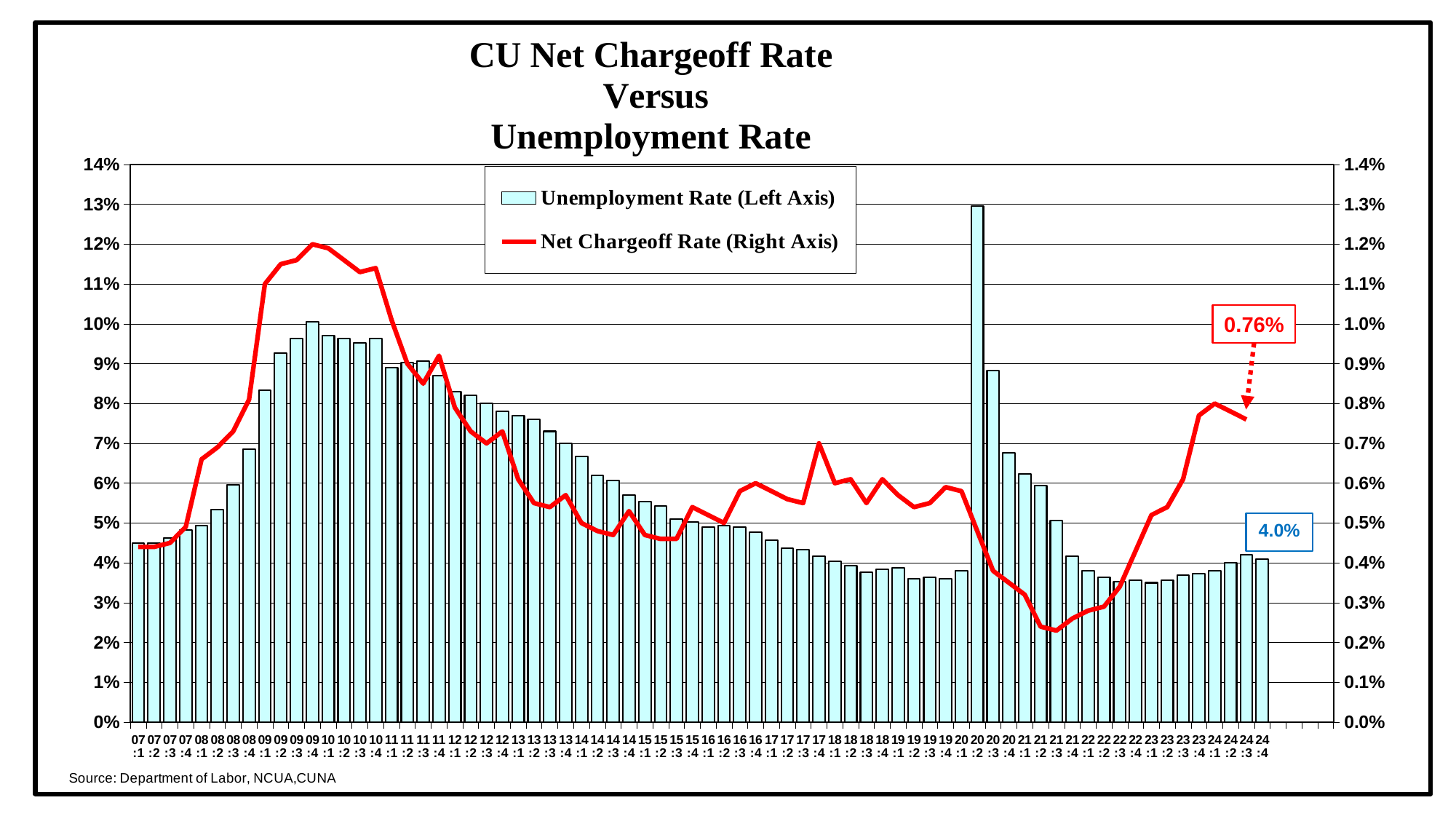
Does the Unemployment Rate generally rise or fall from 10:1 through 19:4? fall Is the Net Chargeoff Rate for 09:4 greater or less than 1.1%? greater Is the Unemployment Rate for 20:2 greater or less than 12%? greater Is the Unemployment Rate for 07:1 greater or less than 5%? less How many series does the legend list? 2 Which quarter has the larger Unemployment Rate, 09:4 or 07:1? 09:4 What kind of chart is shown on the slide? A combined bar and line chart What is the Unemployment Rate for 24:4, as labeled on the chart? 4.0% What is the title of the chart? CU Net Chargeoff Rate Versus Unemployment Rate Which quarter has the highest Unemployment Rate bar? 20:2